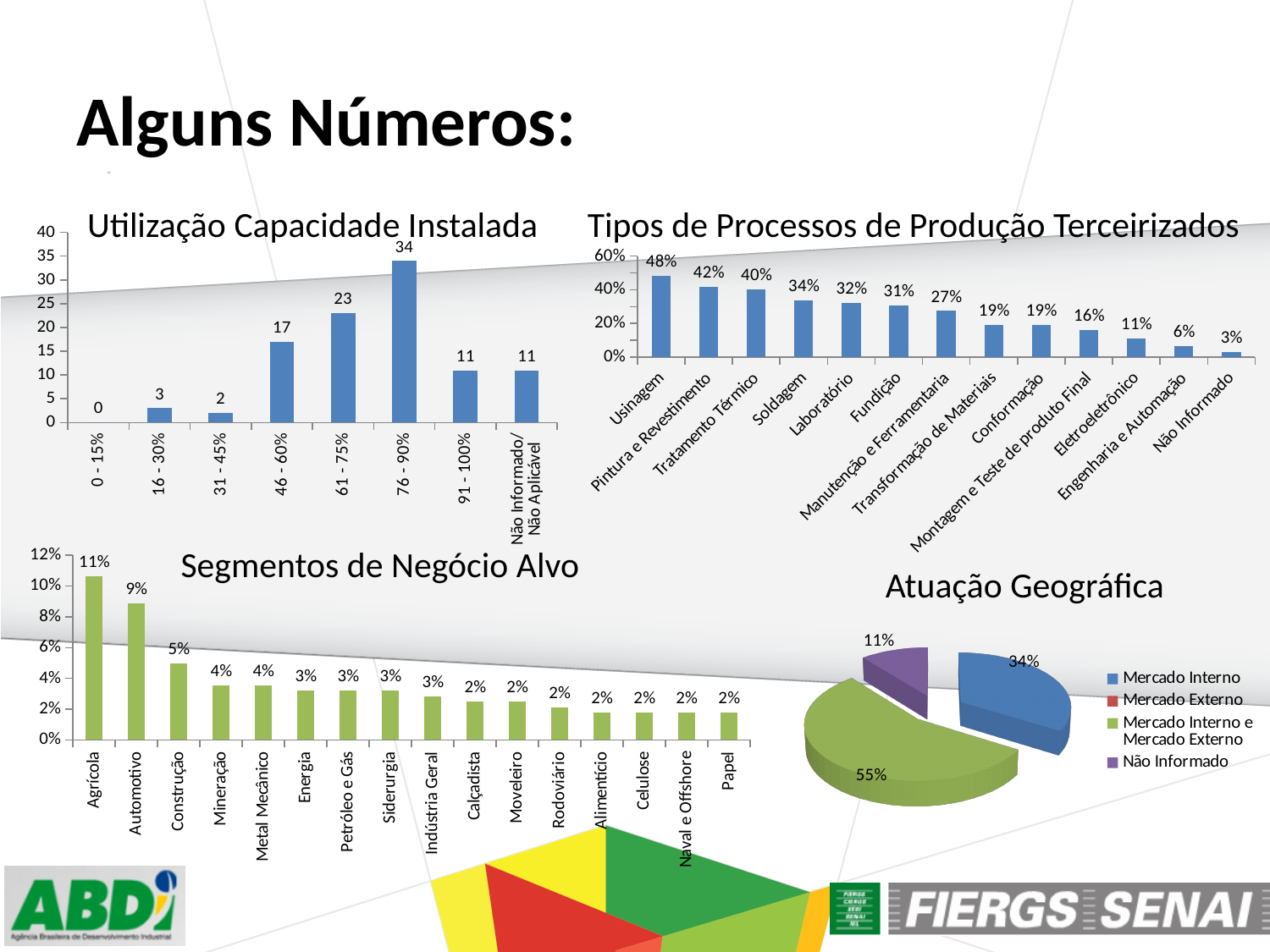
In the 'Utilização Capacidade Instalada' chart, what is the value for the '76 - 90%' category? 34 In the 'Segmentos de Negócio Alvo' chart, which segment has the highest value? Agrícola In the 'Segmentos de Negócio Alvo' chart, what is the value for Automotivo? 9% What type of chart is 'Atuação Geográfica'? Pie chart In the 'Tipos de Processos de Produção Terceirizados' chart, which is larger, Fundição or Laboratório? Laboratório In the 'Utilização Capacidade Instalada' chart, what is the difference between the values for '61 - 75%' and '46 - 60%'? 6 In the 'Tipos de Processos de Produção Terceirizados' chart, what is the value for Soldagem? 34% In the 'Utilização Capacidade Instalada' chart, how many categories are shown on the x axis? 8 In the 'Segmentos de Negócio Alvo' chart, how many segments are shown on the x axis? 16 In the 'Atuação Geográfica' pie chart, what share does 'Mercado Interno e Mercado Externo' have? 55% In the 'Utilização Capacidade Instalada' chart, which category has the highest value? 76 - 90% In the 'Tipos de Processos de Produção Terceirizados' chart, which process has the highest value? Usinagem